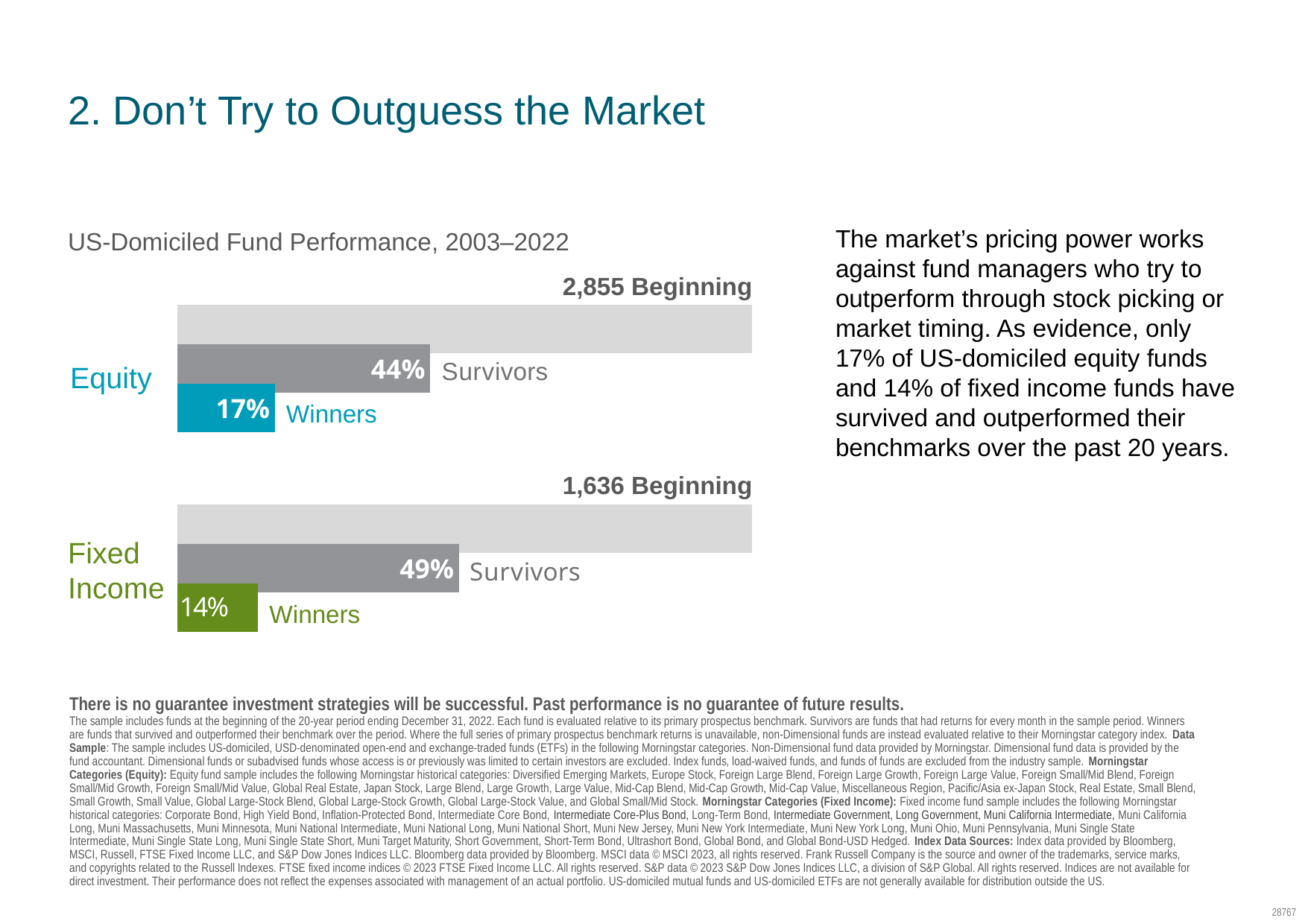
What type of chart is shown on the slide? Bar chart What percentage of equity funds were winners? 17% What is the title of the chart? US-Domiciled Fund Performance, 2003–2022 What percentage of equity funds were survivors? 44% Which category had the higher winner percentage, Equity or Fixed Income? Equity How many equity funds were there at the beginning of the period? 2,855 What percentage of fixed income funds were winners? 14% What is the difference between the survivor and winner percentages for fixed income funds? 35% Which category had the higher survivor percentage, Equity or Fixed Income? Fixed Income What is the difference between the survivor and winner percentages for equity funds? 27% What percentage of fixed income funds were survivors? 49% How many fixed income funds were there at the beginning of the period? 1,636